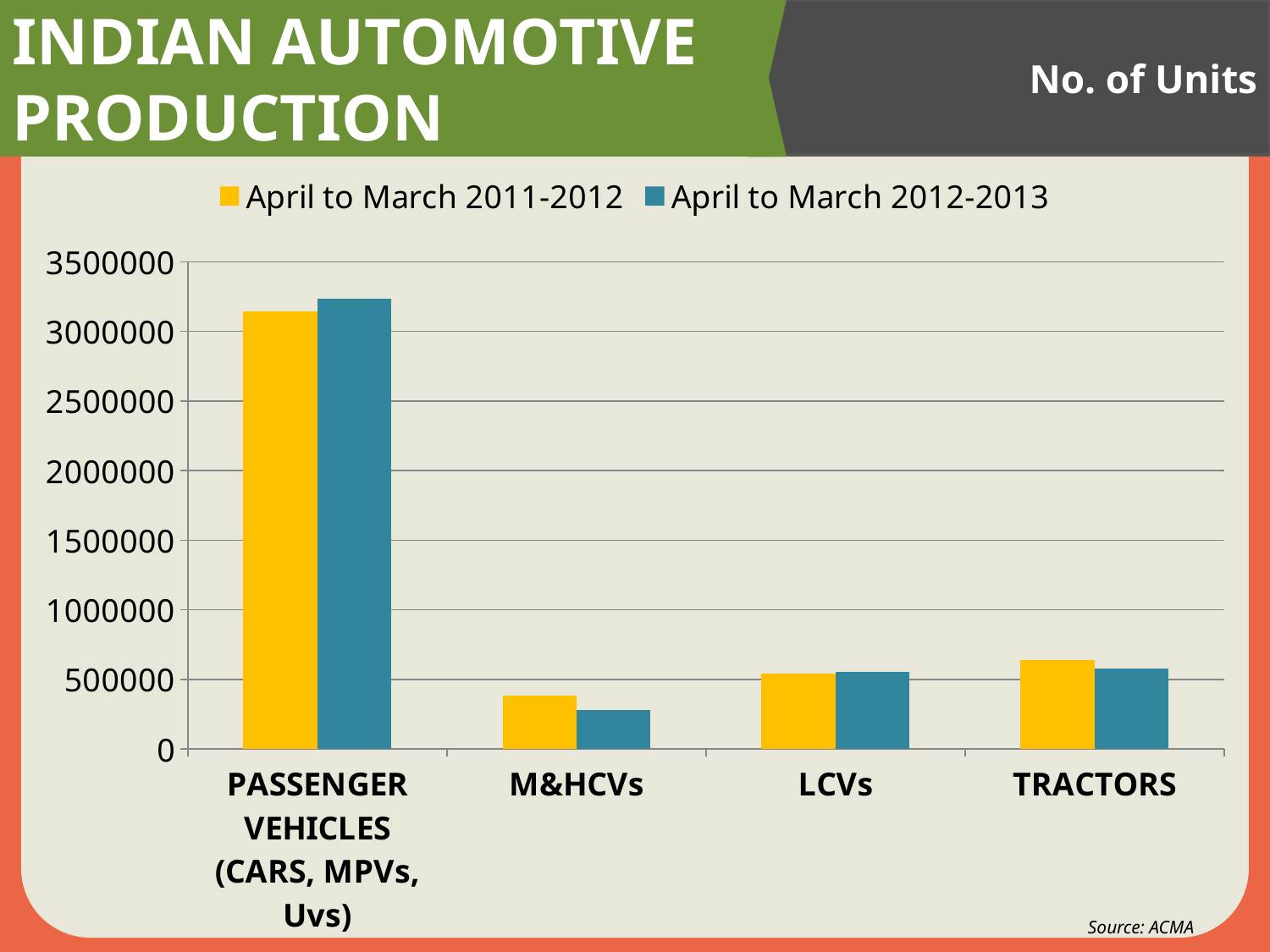
For M&HCVs, which period has the larger value: April to March 2011-2012 or April to March 2012-2013? April to March 2011-2012 Is the value for PASSENGER VEHICLES in April to March 2011-2012 greater or less than 3000000? greater What colour represents the April to March 2011-2012 series in the legend? yellow Is the value for TRACTORS in April to March 2011-2012 greater or less than 500000? greater For PASSENGER VEHICLES, which period has the larger value: April to March 2011-2012 or April to March 2012-2013? April to March 2012-2013 How many vehicle categories are shown on the x axis? 4 Which category has the lowest production for April to March 2011-2012? M&HCVs Which category has the highest production for April to March 2011-2012? PASSENGER VEHICLES (CARS, MPVs, Uvs) Is the value for M&HCVs in April to March 2012-2013 greater or less than 500000? less How many series does the legend list? 2 Which category has the lowest production for April to March 2012-2013? M&HCVs What kind of chart is shown on the slide? bar chart